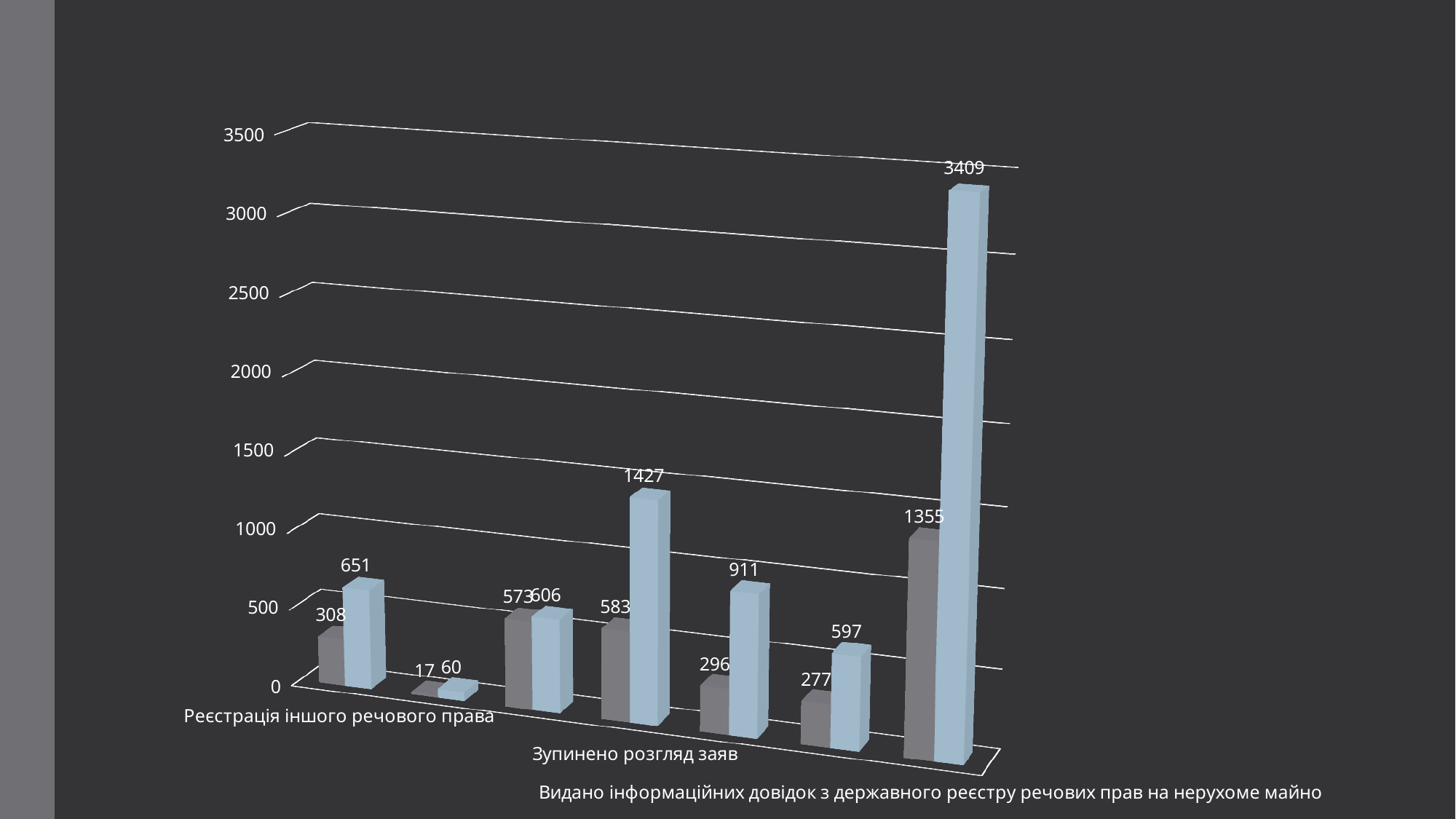
How many category groups of bars are plotted in the chart? 7 What is the difference between the light blue bar and the grey bar for 'Видано інформаційних довідок з державного реєстру речових прав на нерухоме майно'? 2054 What is the difference between the light blue bar and the grey bar for 'Реєстрація іншого речового права'? 343 What is the value of the light blue bar for 'Видано інформаційних довідок з державного реєстру речових прав на нерухоме майно'? 3409 What is the value of the grey bar for 'Реєстрація іншого речового права'? 308 What is the highest value labelled on any bar in the chart? 3409 What is the lowest value labelled on any bar in the chart? 17 What kind of chart is shown on the slide? bar chart What is the value of the grey bar for 'Видано інформаційних довідок з державного реєстру речових прав на нерухоме майно'? 1355 Which bar is larger for 'Реєстрація іншого речового права', the grey bar or the light blue bar? the light blue bar Is the value of the tallest bar in the chart greater or less than 3000? greater What is the value of the light blue bar for 'Реєстрація іншого речового права'? 651